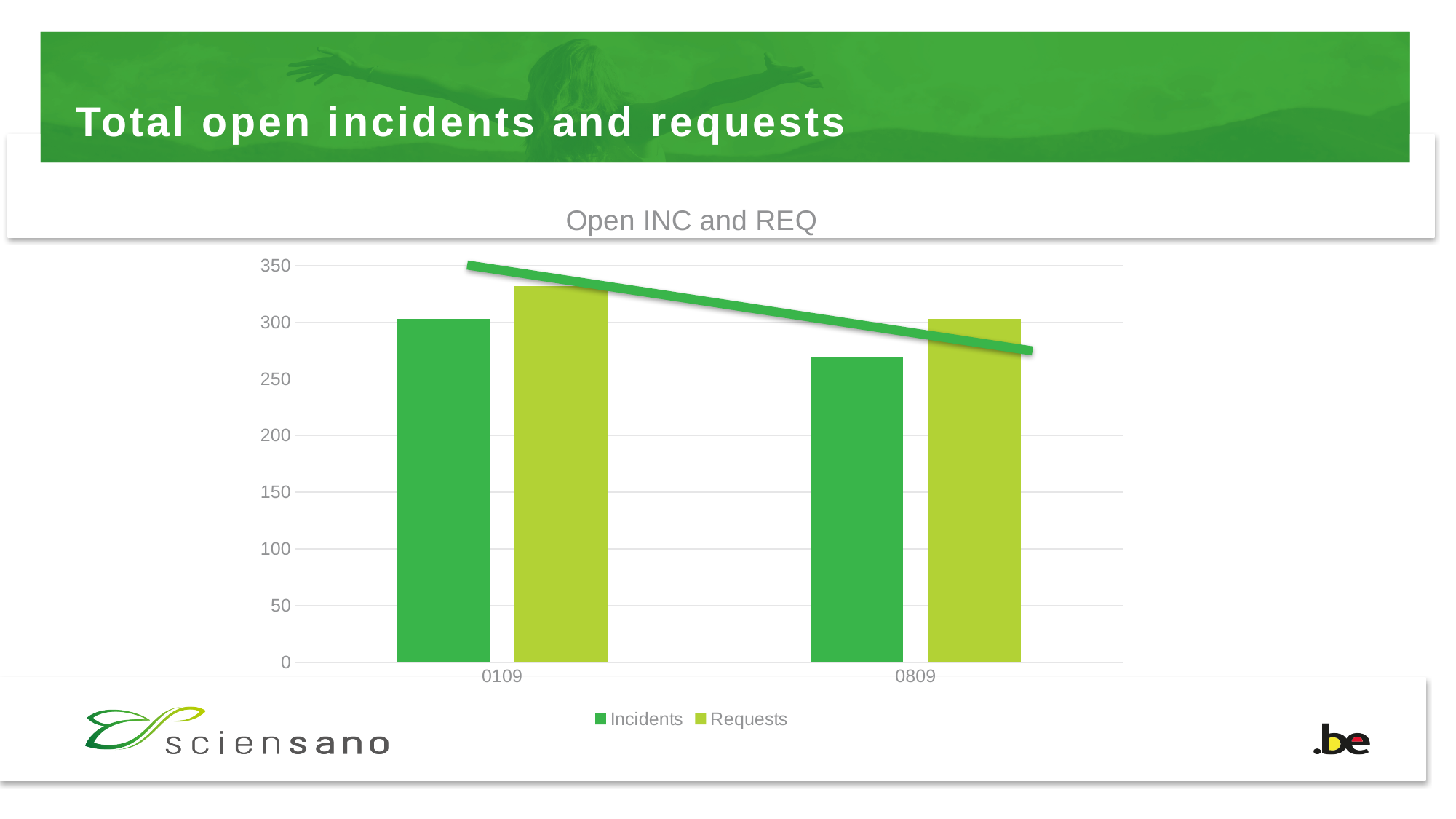
What is the title of the chart? Open INC and REQ Is the value for Requests at 0109 greater or less than 350? less At 0109, which is larger: Incidents or Requests? Requests How many series does the legend list? 2 Is the value for Incidents at 0809 greater or less than 250? greater For Incidents, which category has the higher value: 0109 or 0809? 0109 How many categories are shown on the x axis? 2 Is the value for Incidents at 0809 greater or less than 300? less What kind of chart is shown on the slide? Bar chart Which series is shown in the lighter yellow-green colour? Requests Do the Incidents values rise or fall from 0109 to 0809? Fall